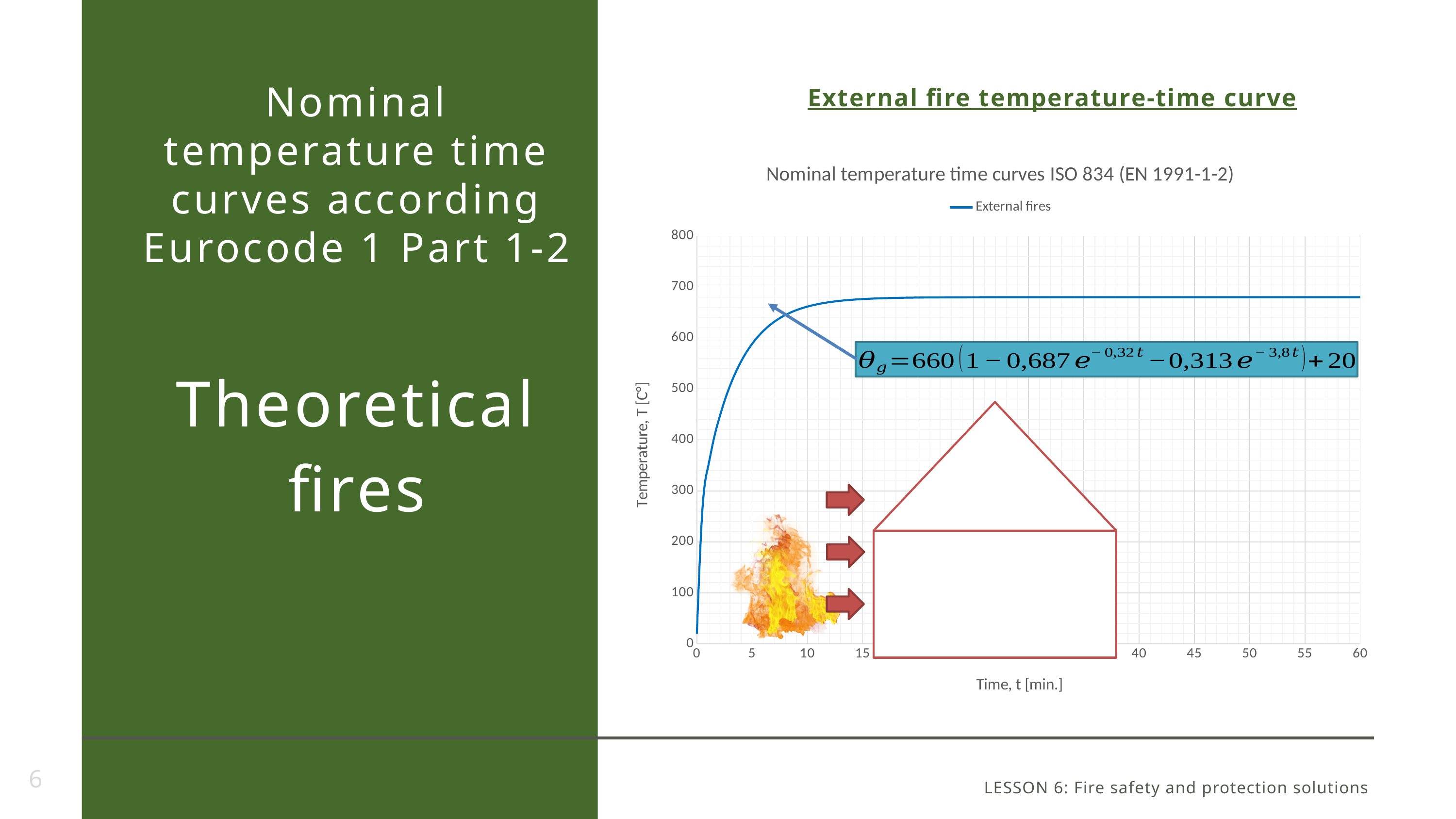
Is the temperature of the External fires curve at 60 minutes greater or less than 700? less How many series does the chart legend list? 1 What is the highest value shown on the x axis (Time, t [min.])? 60 Is the temperature of the External fires curve at 30 minutes greater or less than 700? less What is the name of the series shown in the chart legend? External fires What kind of chart is shown on the slide? line chart What is the title of the chart? Nominal temperature time curves ISO 834 (EN 1991-1-2) Is the temperature of the External fires curve at 10 minutes greater or less than 600? greater Does the External fires curve rise or fall as time increases from 0 to 10 minutes? rise